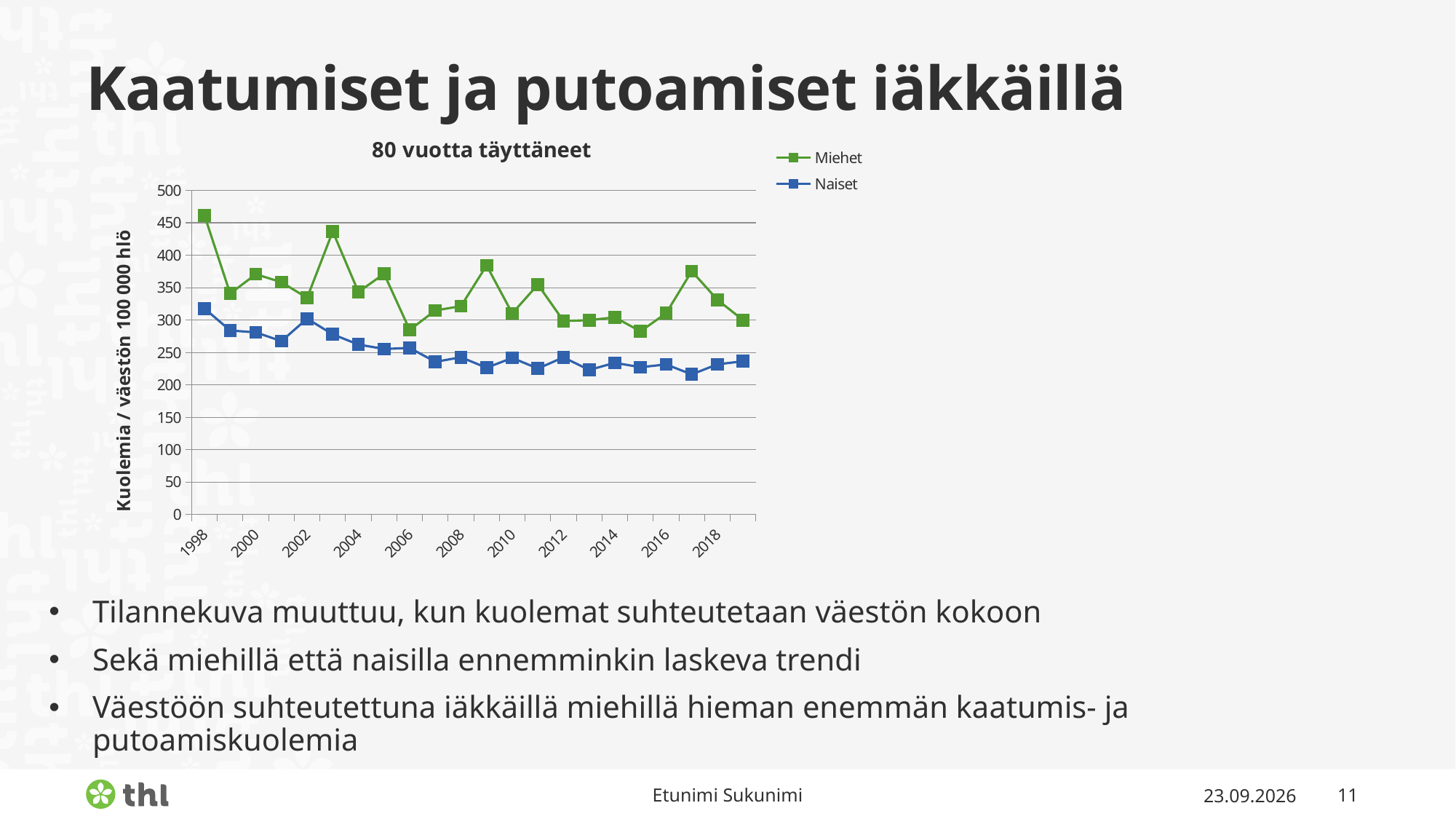
How many series does the chart legend list? 2 Which series has the higher value in 1998, Miehet or Naiset? Miehet What kind of chart is shown on the slide? line chart In which year does the Miehet series reach its highest value? 1998 What is the title of the chart? 80 vuotta täyttäneet Does the Naiset series generally rise or fall from 1998 to 2019? fall What colour is the Miehet line in the chart? green In which year does the Naiset series reach its highest value? 1998 Is the value for Miehet in 2003 greater or less than 400? greater Is the value for Miehet in 1998 greater or less than 450? greater Is the value for Naiset in 1998 greater or less than 300? greater